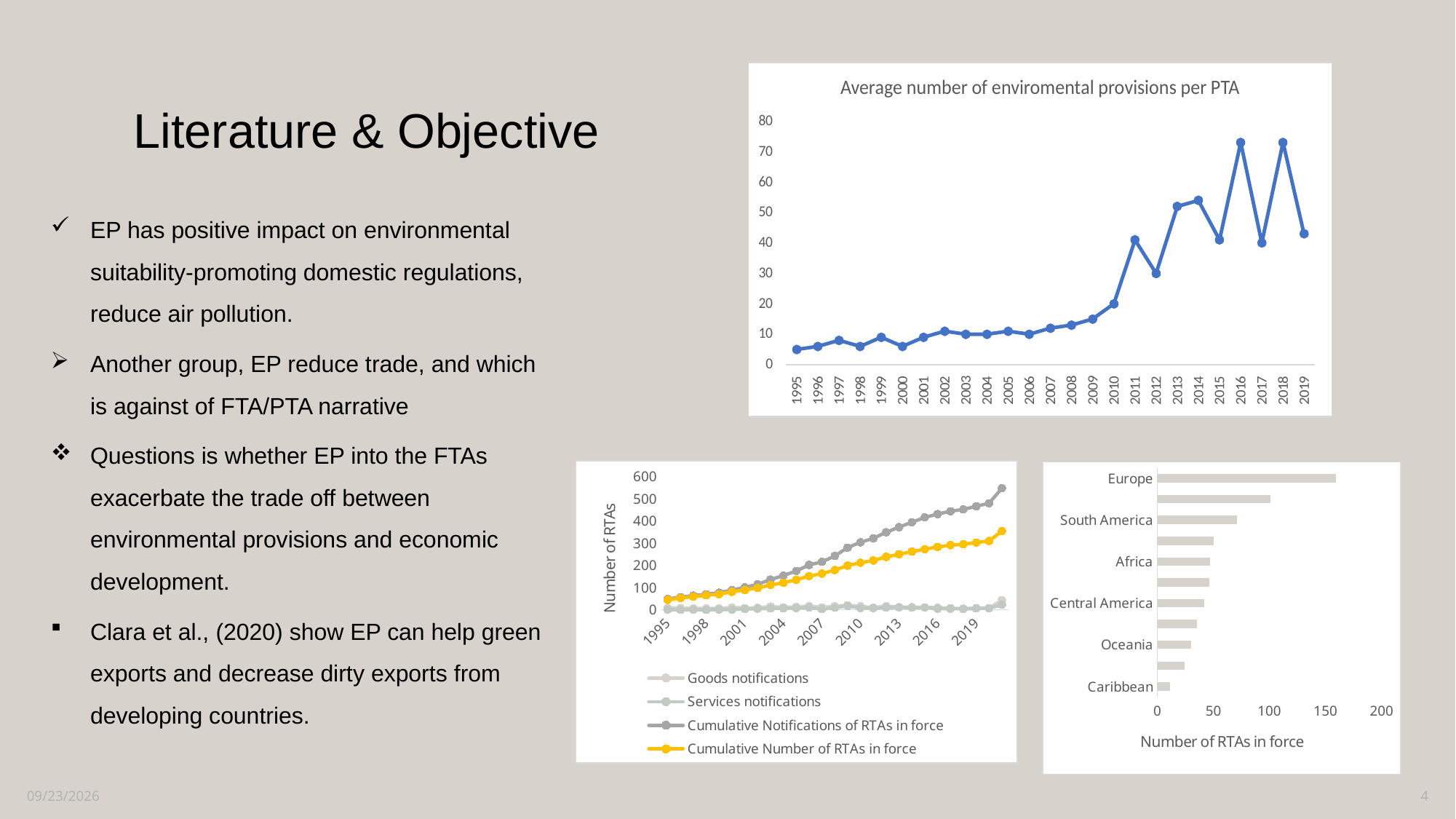
In the bottom-middle line chart, which series has the highest value at the last point? Cumulative Notifications of RTAs in force In the bottom-right bar chart, is the value for Europe greater or less than 150? greater In the bottom-right bar chart, which labeled region has the highest number of RTAs in force? Europe How many series does the legend of the bottom-middle line chart list? 4 In the 'Average number of enviromental provisions per PTA' chart, how many years are shown on the x axis? 25 In the 'Average number of enviromental provisions per PTA' chart, do values generally rise or fall from 1995 to 2019? rise What kind of chart is the 'Average number of enviromental provisions per PTA' chart? line chart In the 'Average number of enviromental provisions per PTA' chart, is the value for 2011 greater or less than 30? greater In the bottom-middle line chart, is the last value of 'Cumulative Number of RTAs in force' greater or less than 300? greater In the 'Average number of enviromental provisions per PTA' chart, which year has the larger value, 2016 or 2017? 2016 What kind of chart is the bottom-right chart showing 'Number of RTAs in force' by region? bar chart